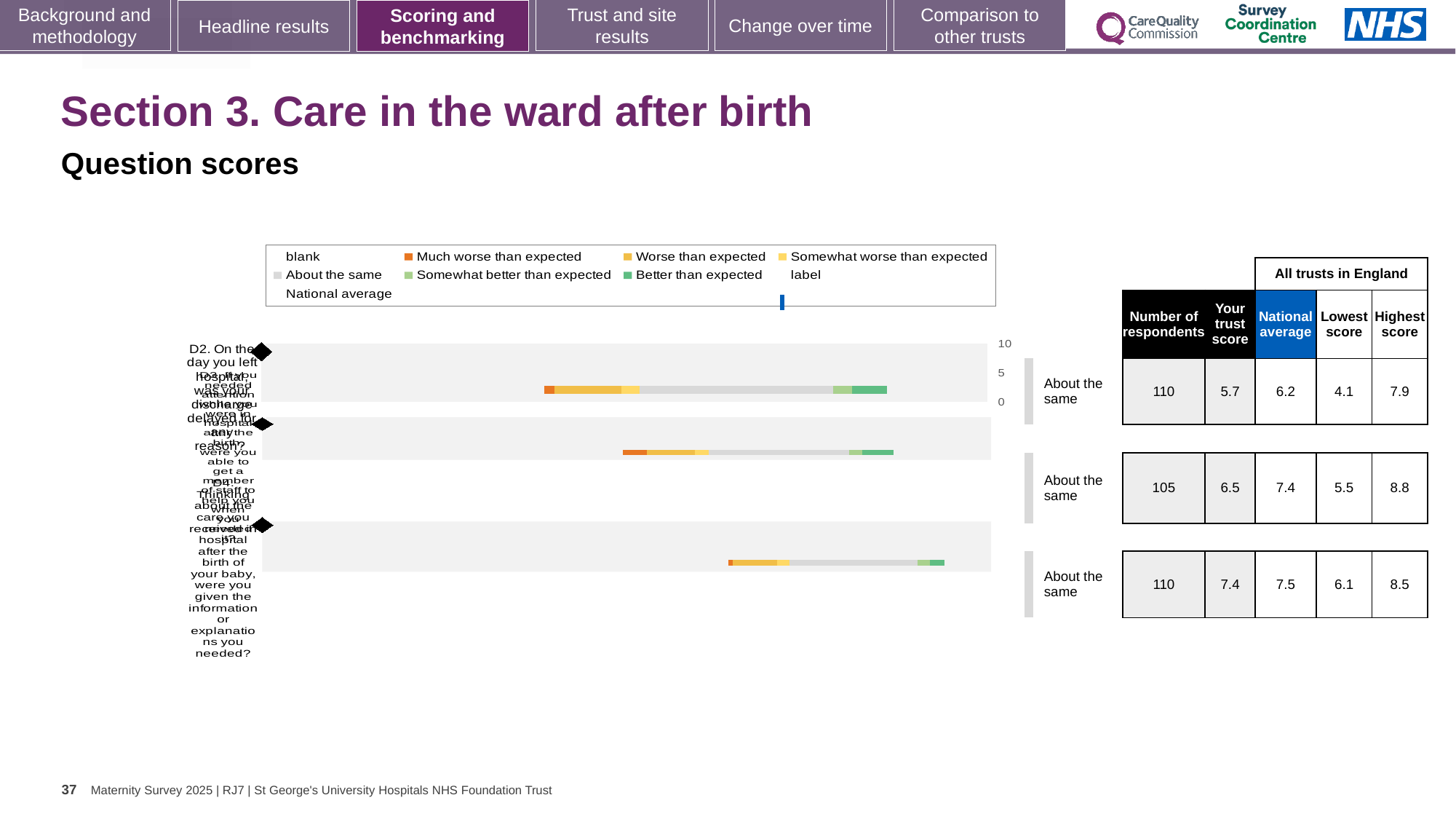
Which bar row has the lowest 'Lowest score' value? the first (top) bar Which bar row has the highest 'Your trust score' value? the third (bottom) bar What benchmark category is shown next to each of the three bars? About the same What is the 'Your trust score' value shown for the first (top) bar of the chart? 5.7 What is the difference between the 'National average' and 'Your trust score' for the second (middle) bar? 0.9 What kind of chart is shown on the slide? bar chart What is the 'Highest score' value shown for the third (bottom) bar of the chart? 8.5 Is the 'Your trust score' for the first (top) bar larger or smaller than its 'National average'? smaller What is the 'National average' value shown for the second (middle) bar of the chart? 7.4 How many bars (question rows) are plotted in the chart? 3 What is the highest value shown on the chart's numeric axis? 10 Which legend entry is represented by the blue marker in the chart legend? National average